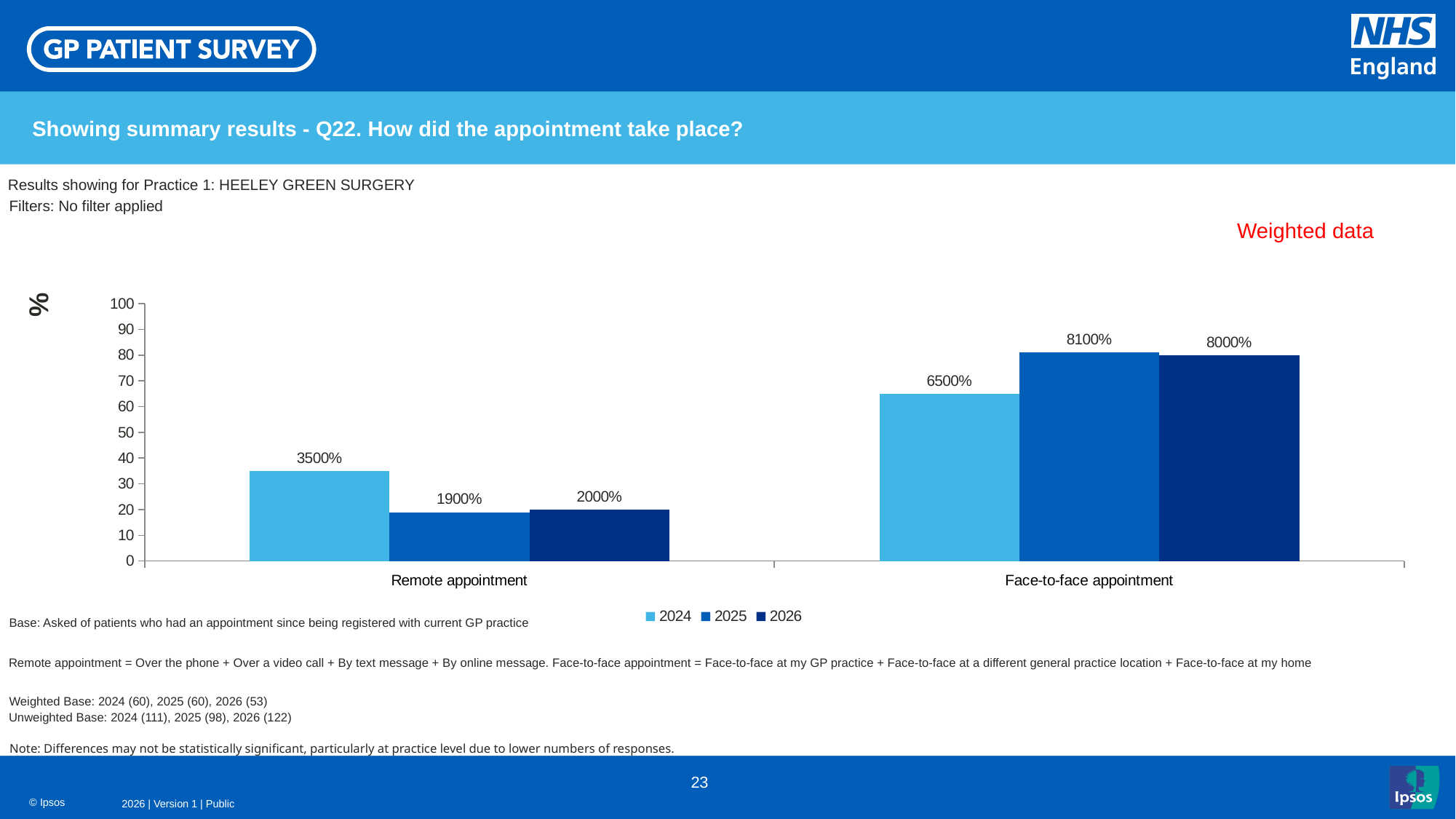
Is the 2026 bar for Face-to-face appointment greater or less than 90 on the axis? less How many categories are shown on the x axis? 2 What kind of chart is shown on the slide? Bar chart What is the data label shown for 2026 in the Remote appointment category? 2000% What is the data label shown for 2025 in the Face-to-face appointment category? 8100% What is the data label shown for 2024 in the Face-to-face appointment category? 6500% Which year has the lowest bar in the Remote appointment category? 2025 Which is larger: the 2024 bar for Remote appointment or the 2024 bar for Face-to-face appointment? Face-to-face appointment Which year has the highest bar in the Face-to-face appointment category? 2025 What is the data label shown for 2024 in the Remote appointment category? 3500% Is the 2024 bar for Remote appointment greater or less than 30 on the axis? greater How many series does the legend list? 3